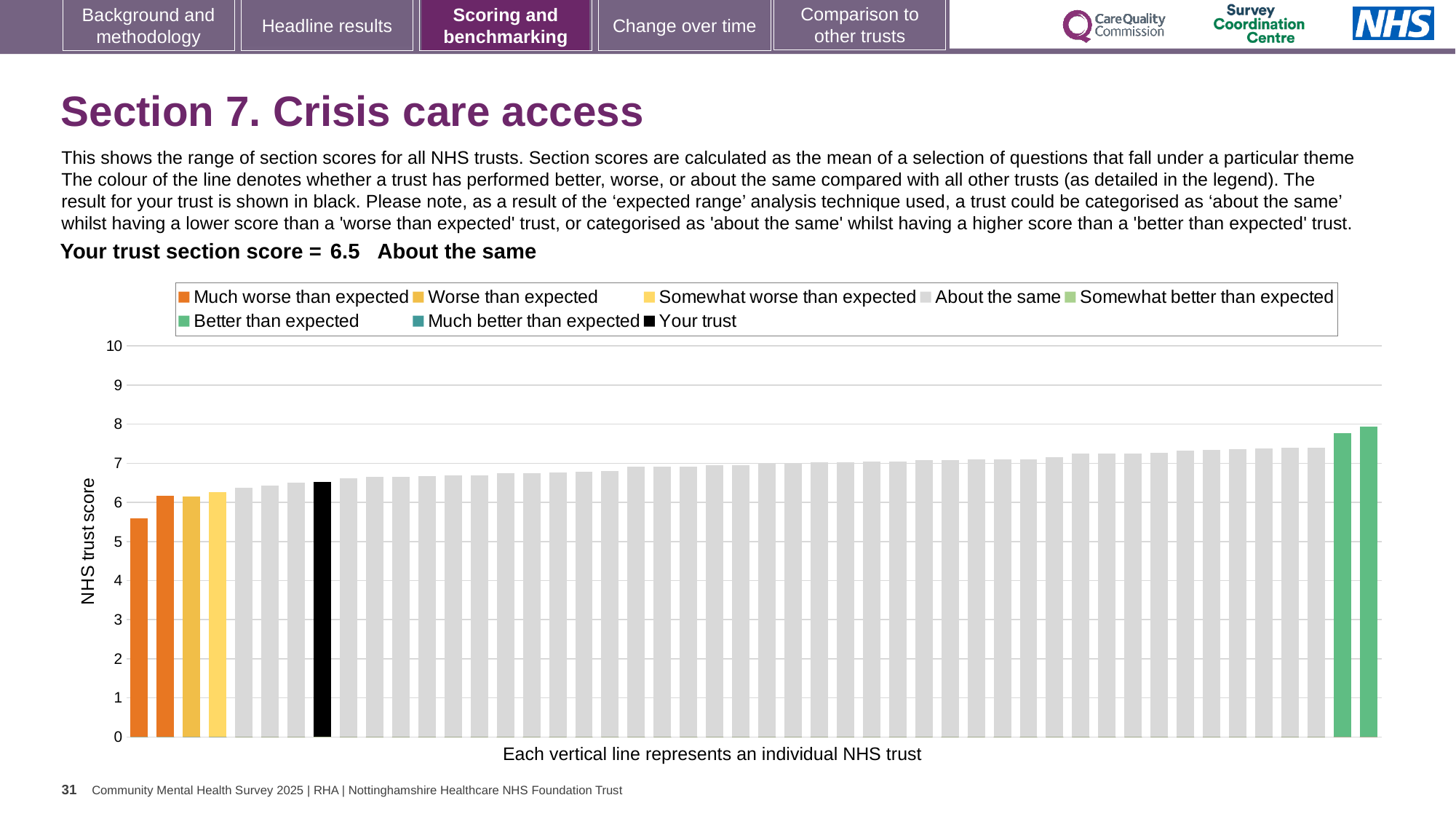
What colour is used for the bar representing your trust? black What is the label on the vertical axis of the chart? NHS trust score What is the section score for your trust shown on the slide? 6.5 Do the bar values rise or fall from left to right along the x axis? rise What kind of chart is shown on the slide? bar chart Is the value of the black bar (your trust) greater or less than 6? greater Which legend category do the two highest bars belong to? Better than expected How many entries does the chart legend list? 8 Is the value of the lowest bar in the chart greater or less than 6? less Is the value of the highest bar in the chart greater or less than 7? greater